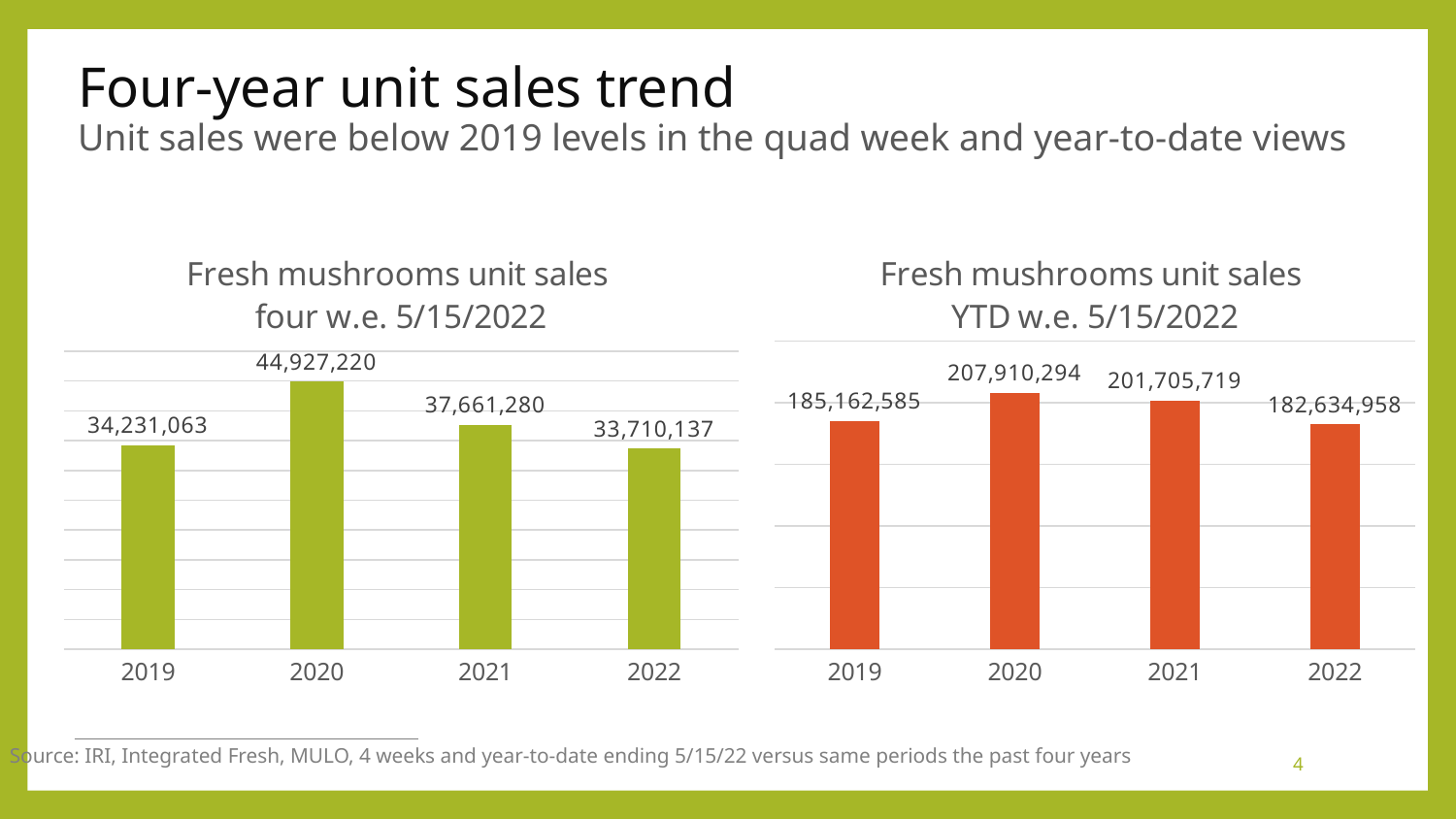
What colour are the bars in the 'Fresh mushrooms unit sales YTD w.e. 5/15/2022' chart? Orange What kind of chart is the 'Fresh mushrooms unit sales YTD w.e. 5/15/2022' chart? Bar chart In the 'Fresh mushrooms unit sales YTD w.e. 5/15/2022' chart, which is larger, the value for 2019 or the value for 2022? 2019 In the 'Fresh mushrooms unit sales four w.e. 5/15/2022' chart, do the values rise or fall from 2020 to 2022? Fall In the 'Fresh mushrooms unit sales YTD w.e. 5/15/2022' chart, what is the difference between the 2020 and 2021 values? 6,204,575 In the 'Fresh mushrooms unit sales four w.e. 5/15/2022' chart, which year has the lowest value? 2022 In the 'Fresh mushrooms unit sales YTD w.e. 5/15/2022' chart, what is the value for 2022? 182,634,958 In the 'Fresh mushrooms unit sales four w.e. 5/15/2022' chart, what is the value for 2021? 37,661,280 In the 'Fresh mushrooms unit sales four w.e. 5/15/2022' chart, what is the value for 2020? 44,927,220 In the 'Fresh mushrooms unit sales YTD w.e. 5/15/2022' chart, which year has the highest value? 2020 How many years are shown on the x axis of the 'Fresh mushrooms unit sales four w.e. 5/15/2022' chart? 4 In the 'Fresh mushrooms unit sales four w.e. 5/15/2022' chart, what is the difference between the 2020 and 2019 values? 10,696,157